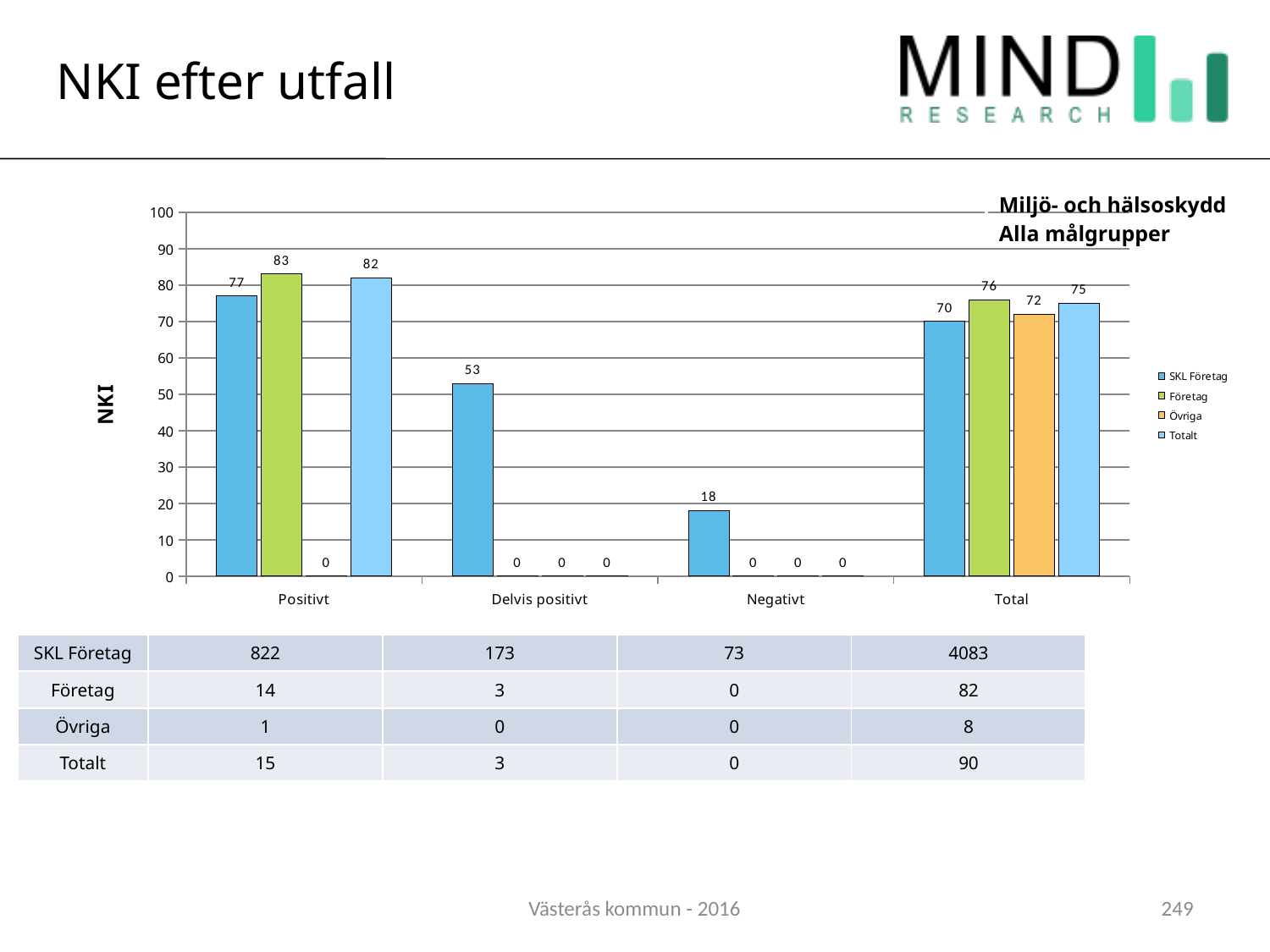
What kind of chart is shown on the slide? bar chart What is the NKI value for SKL Företag in the Delvis positivt category? 53 What is the difference between the Företag and SKL Företag values in the Positivt category? 6 How many categories are shown on the x axis of the chart? 4 Which series has the lowest NKI value in the Total category? SKL Företag Which series has the highest NKI value in the Total category? Företag What is the NKI value for Företag in the Positivt category? 83 Is the SKL Företag value for Delvis positivt greater or less than 60? less What is the NKI value for Övriga in the Total category? 72 Which is larger: the Totalt value for Positivt or the Totalt value for Total? Positivt How many series does the chart legend list? 4 What is the NKI value for SKL Företag in the Negativt category? 18